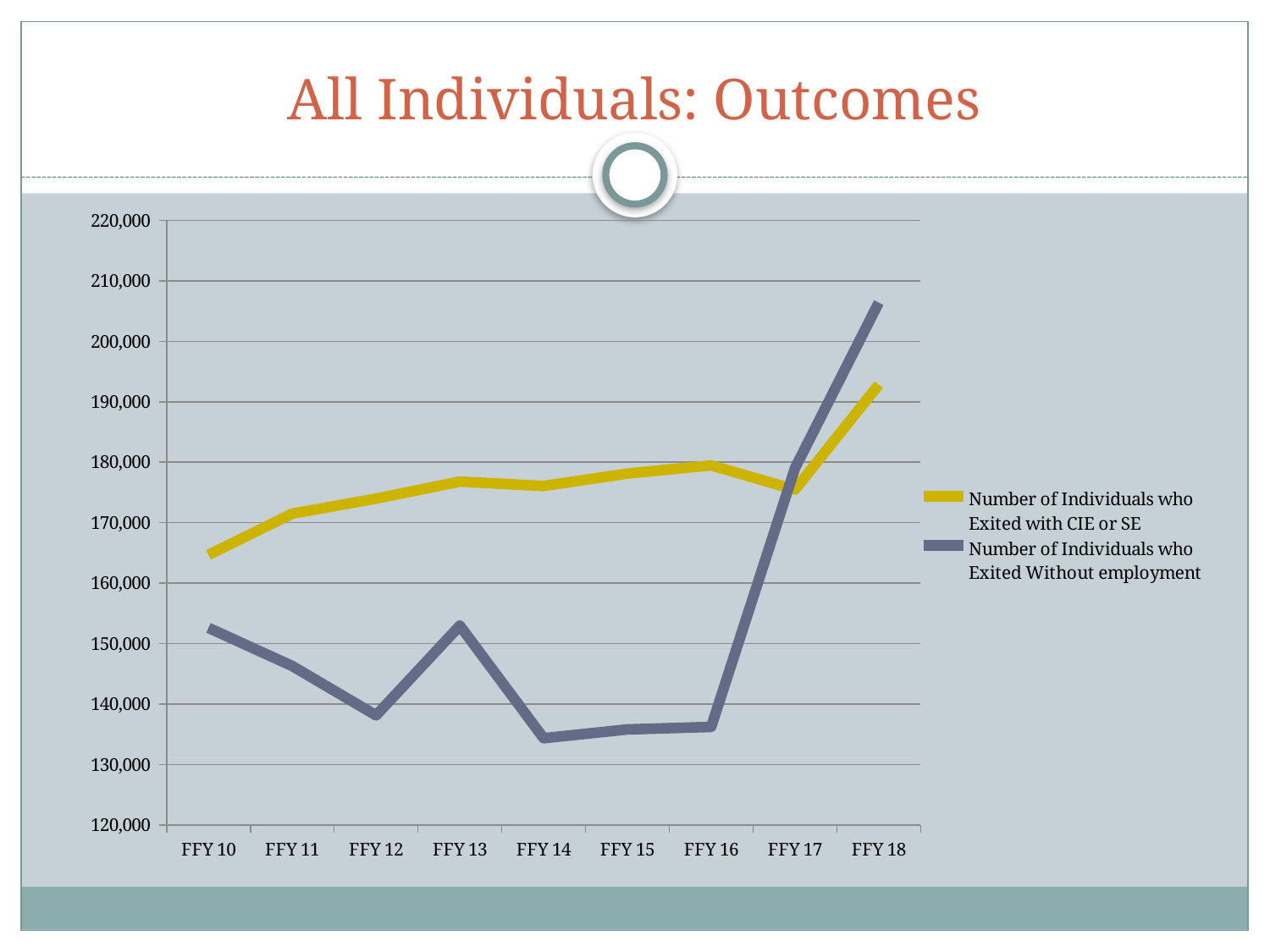
What kind of chart is shown on the slide? Line chart In which fiscal year is the Number of Individuals who Exited with CIE or SE lowest? FFY 10 Is the value for Number of Individuals who Exited Without employment in FFY 14 greater or less than 140,000? less How many fiscal years are plotted along the x axis? 9 In which fiscal year is the Number of Individuals who Exited Without employment highest? FFY 18 Is the value for Number of Individuals who Exited with CIE or SE in FFY 10 greater or less than 170,000? less Does the Number of Individuals who Exited Without employment rise or fall from FFY 16 to FFY 18? Rise Is the value for Number of Individuals who Exited Without employment in FFY 18 greater or less than 200,000? greater In FFY 10, which series has the larger value: Exited with CIE or SE, or Exited Without employment? Exited with CIE or SE Which series is drawn in yellow? Number of Individuals who Exited with CIE or SE What is the title of the slide containing the chart? All Individuals: Outcomes How many series does the legend list? 2